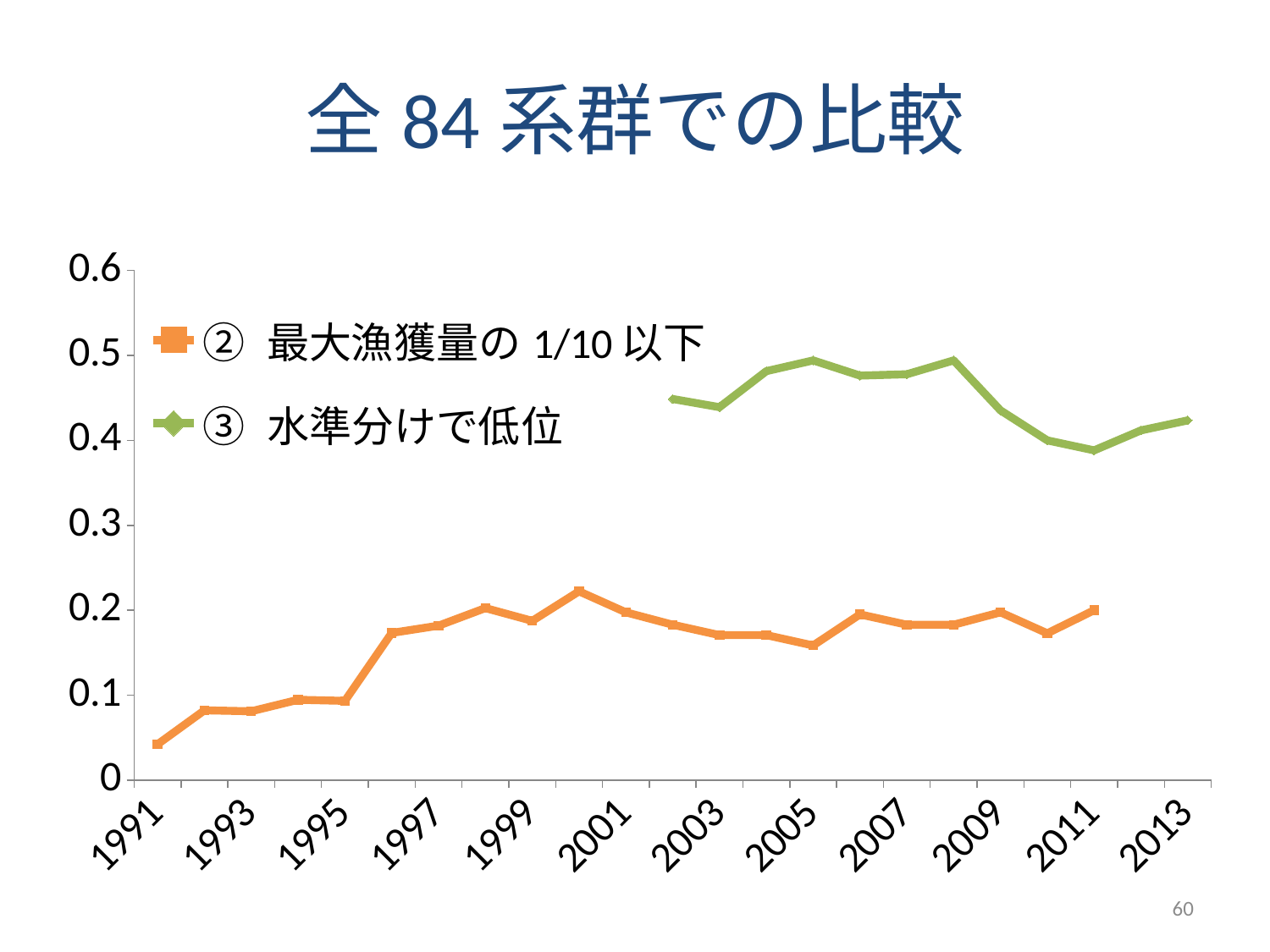
How many series does the legend list? 2 Which legend entry is drawn in green? ③ 水準分けで低位 Is the value for ② 最大漁獲量の 1/10 以下 in 1997 greater or less than 0.1? greater Does the value for ③ 水準分けで低位 rise or fall from 2008 to 2011? fall In which year is the value for ② 最大漁獲量の 1/10 以下 lowest? 1991 In 2005, which series has the larger value, ② 最大漁獲量の 1/10 以下 or ③ 水準分けで低位? ③ 水準分けで低位 Is the value for ② 最大漁獲量の 1/10 以下 in 1991 greater or less than 0.1? less In which year is the value for ② 最大漁獲量の 1/10 以下 highest? 2000 What is the title of the chart on the slide? 全 84 系群での比較 Is the value for ② 最大漁獲量の 1/10 以下 in 2000 greater or less than 0.2? greater What kind of chart is shown on the slide? line chart